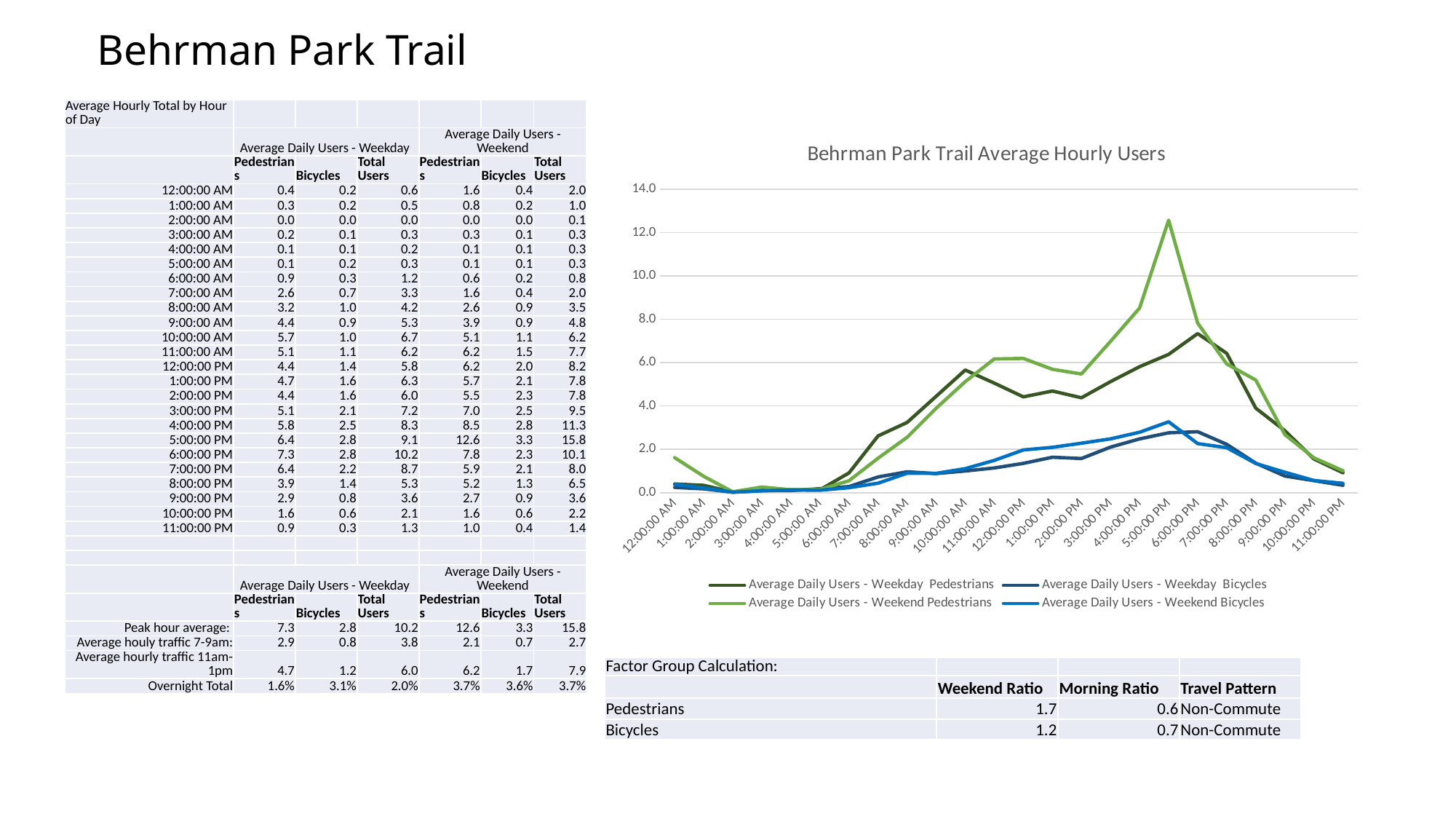
In the "Behrman Park Trail Average Hourly Users" chart, is the Weekend Pedestrians value at 5:00:00 PM greater or less than 12.0? greater In the "Behrman Park Trail Average Hourly Users" chart, at 5:00:00 PM which is larger: Weekend Pedestrians or Weekday Pedestrians? Weekend Pedestrians In the "Behrman Park Trail Average Hourly Users" chart, at which hour does the Weekend Pedestrians series peak? 5:00:00 PM In the "Behrman Park Trail Average Hourly Users" chart, which series reaches the highest value? Average Daily Users - Weekend Pedestrians In the "Behrman Park Trail Average Hourly Users" chart, do the Weekend Pedestrians values rise or fall from 6:00:00 PM to 11:00:00 PM? fall What is the Weekday Pedestrians value at 6:00:00 PM, as shown in the table on the slide? 7.3 How many series does the legend of the "Behrman Park Trail Average Hourly Users" chart list? 4 Using the table values, what is the difference between Weekend Pedestrians (12.6) and Weekday Pedestrians (6.4) at 5:00:00 PM? 6.2 What is the Weekend Pedestrians value at 5:00:00 PM, as shown in the table on the slide? 12.6 How many hourly points are plotted along the x axis of the "Behrman Park Trail Average Hourly Users" chart? 24 In the "Behrman Park Trail Average Hourly Users" chart, is the Weekday Pedestrians value at 6:00:00 PM greater or less than 8.0? less What type of chart is "Behrman Park Trail Average Hourly Users"? line chart